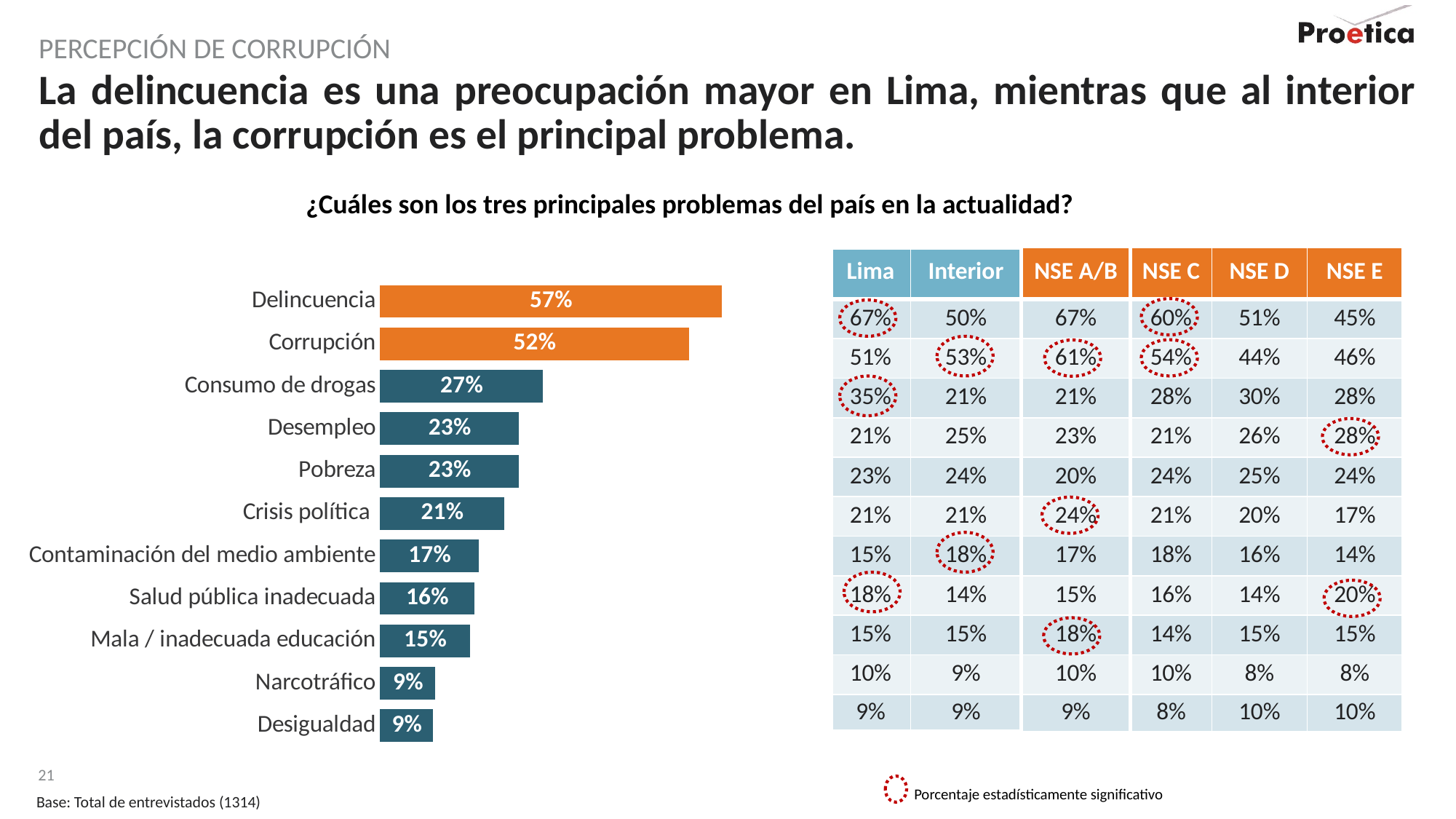
What kind of chart is shown on the slide? Bar chart What is the value for Consumo de drogas in the bar chart? 27% What is the value for Delincuencia in the bar chart? 57% What is the value for Contaminación del medio ambiente in the bar chart? 17% Which is larger in the bar chart, the value for Crisis política or the value for Salud pública inadecuada? Crisis política Which category has the highest value in the bar chart? Delincuencia Which two categories in the bar chart both have a value of 23%? Desempleo and Pobreza What is the value for Narcotráfico in the bar chart? 9% What is the difference between the values for Consumo de drogas and Desempleo in the bar chart? 4% How many categories are shown in the bar chart? 11 Which bars in the chart are coloured orange? Delincuencia and Corrupción What is the difference between the values for Delincuencia and Corrupción in the bar chart? 5%